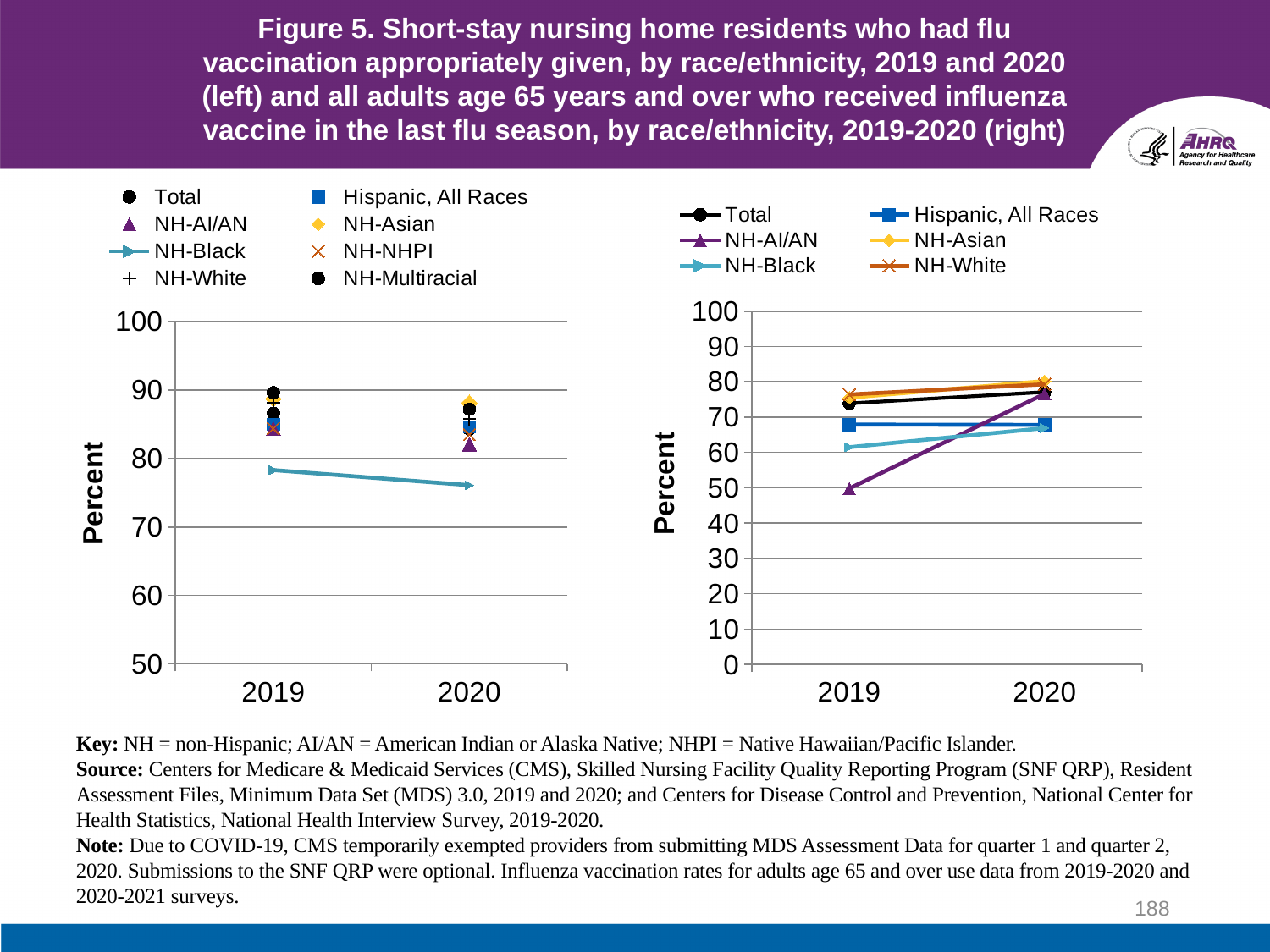
In the right chart (adults age 65 and over), does the value for NH-AI/AN rise or fall from 2019 to 2020? Rise In the left chart (short-stay nursing home residents), is the value for NH-Black in 2020 greater or less than 80? less How many years are shown on the x axis of the left chart (short-stay nursing home residents)? 2 In the left chart (short-stay nursing home residents), which race/ethnicity group has the lowest value in 2019? NH-Black In the right chart (adults age 65 and over), is the value for NH-Asian in 2020 greater or less than 70? greater How many series does the legend of the left chart (short-stay nursing home residents) list? 8 In the left chart (short-stay nursing home residents), which is larger in 2019: Total or NH-Black? Total How many series does the legend of the right chart (adults age 65 and over) list? 6 In the right chart (adults age 65 and over), which race/ethnicity group has the lowest value in 2019? NH-AI/AN In the left chart (short-stay nursing home residents), does the value for NH-Black rise or fall from 2019 to 2020? Fall What kind of chart is the right chart (adults age 65 and over)? Line chart In the right chart (adults age 65 and over), is the value for NH-AI/AN in 2019 greater or less than 60? less